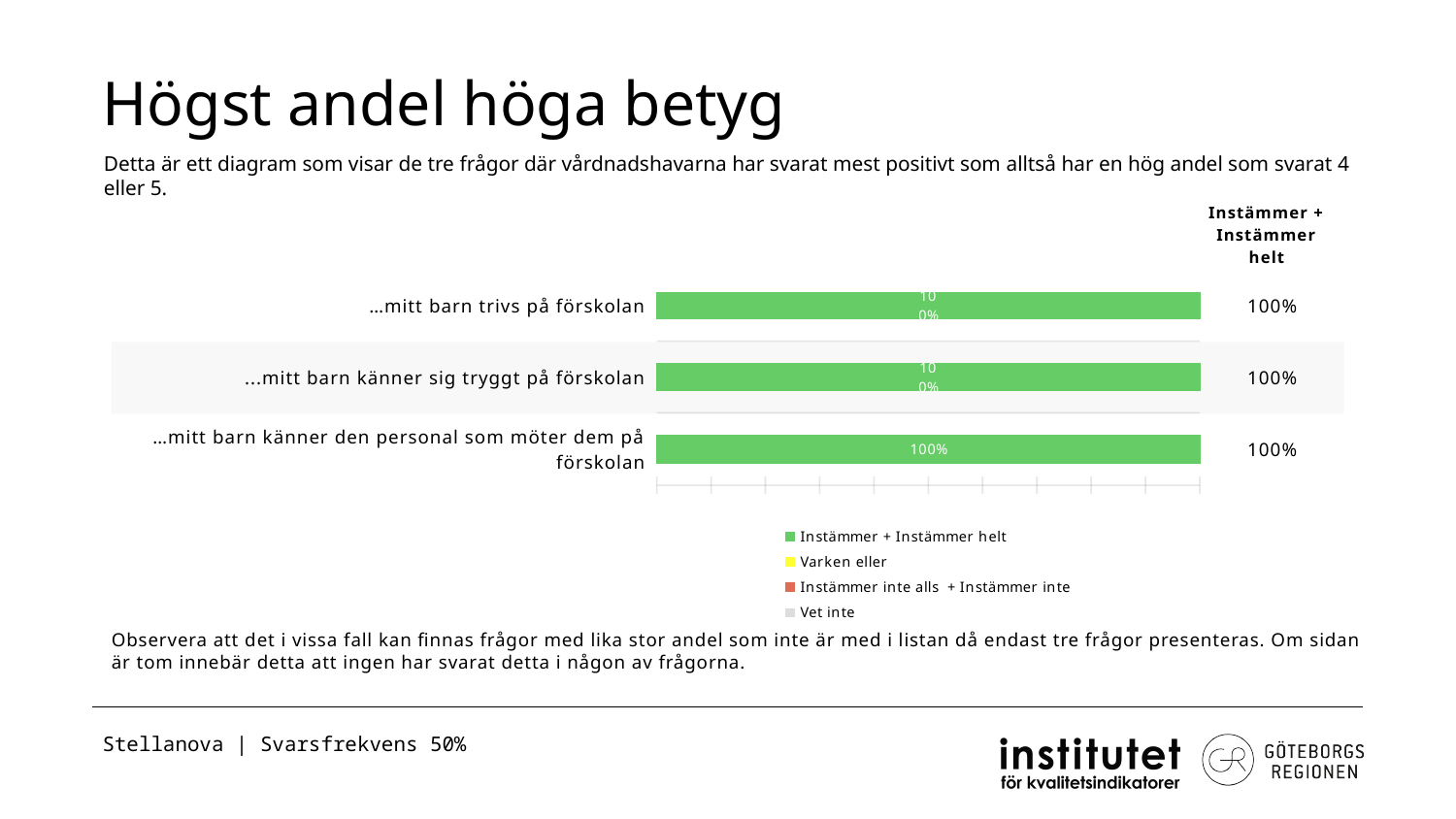
What is the 'Instämmer + Instämmer helt' value for '...mitt barn känner sig tryggt på förskolan'? 100% What is the 'Instämmer + Instämmer helt' value for '…mitt barn trivs på förskolan'? 100% What kind of chart is shown on the slide? bar chart What is the total of the stacked bar for '…mitt barn känner den personal som möter dem på förskolan'? 100% How many categories (questions) are plotted in the chart? 3 Which legend entry is listed first in the chart legend? Instämmer + Instämmer helt What is the 'Instämmer + Instämmer helt' value for '…mitt barn känner den personal som möter dem på förskolan'? 100% What colour represents 'Instämmer + Instämmer helt' in the chart? green How many series does the chart legend list? 4 Is the 'Instämmer + Instämmer helt' value for '…mitt barn trivs på förskolan' greater or less than 50%? greater What is the difference between the 'Instämmer + Instämmer helt' values for '…mitt barn trivs på förskolan' and '...mitt barn känner sig tryggt på förskolan'? 0%